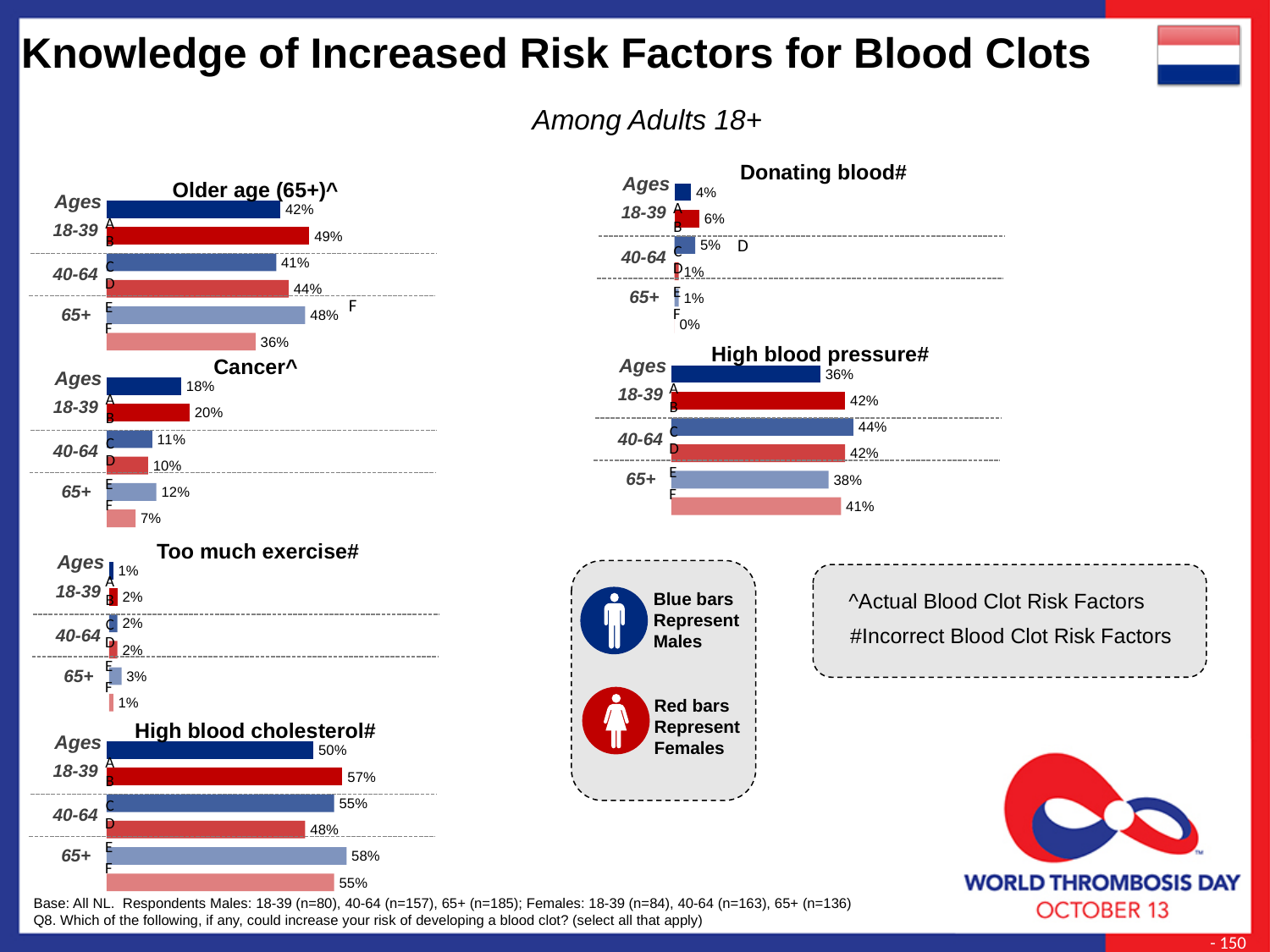
In the "Cancer^" chart, what is the difference between the male and female values for ages 65+? 5% What type of chart is used for "High blood pressure#"? Bar chart In the "High blood cholesterol#" chart, which is larger for ages 40-64: the male value or the female value? Male (55%) In the "Cancer^" chart, what is the value for males aged 18-39? 18% In the "Older age (65+)^" chart, which bar has the lowest value? Females 65+ (36%) In the "High blood pressure#" chart, what is the difference between the female and male values for ages 18-39? 6% In the "Older age (65+)^" chart, what percentage of females aged 18-39 is shown? 49% In the "Too much exercise#" chart, which bar has the highest value? Males 65+ (3%) How many bars does the "Donating blood#" chart contain? 6 In the "High blood cholesterol#" chart, what is the value for males aged 65+? 58% In the "High blood pressure#" chart, what is the value for males aged 40-64? 44% In the "Donating blood#" chart, what is the value for females aged 65+? 0%